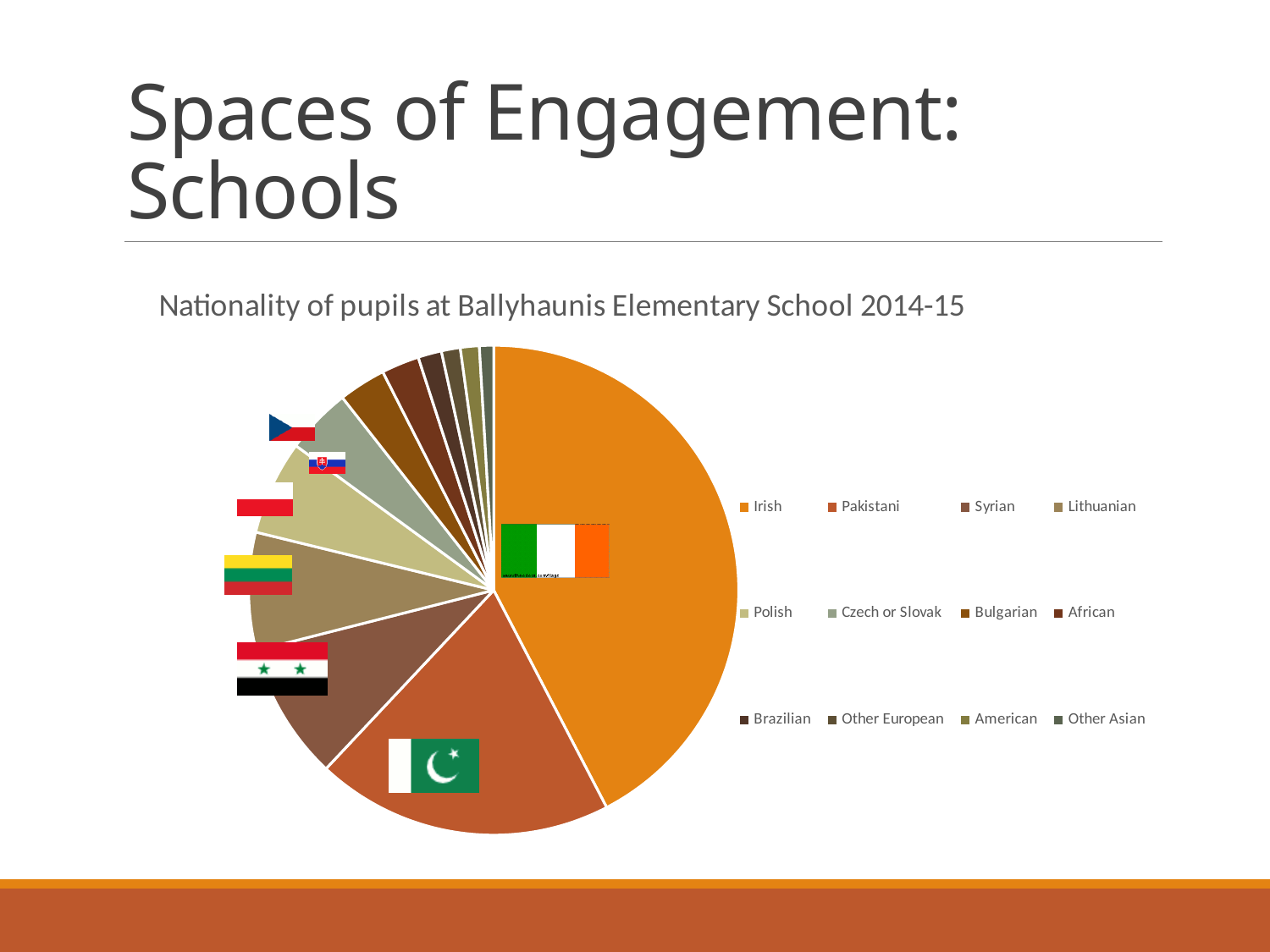
How many nationality categories does the pie chart show? 12 Which slice is larger, Lithuanian or Bulgarian? Lithuanian Which slice is larger, Pakistani or Syrian? Pakistani Which slice is larger, Irish or Pakistani? Irish Which nationality has the largest slice of the pie chart? Irish Which nationality has the second-largest slice of the pie chart? Pakistani What kind of chart is shown on the slide? Pie chart What is the title of the chart? Nationality of pupils at Ballyhaunis Elementary School 2014-15 Which legend entry is listed first in the chart's legend? Irish